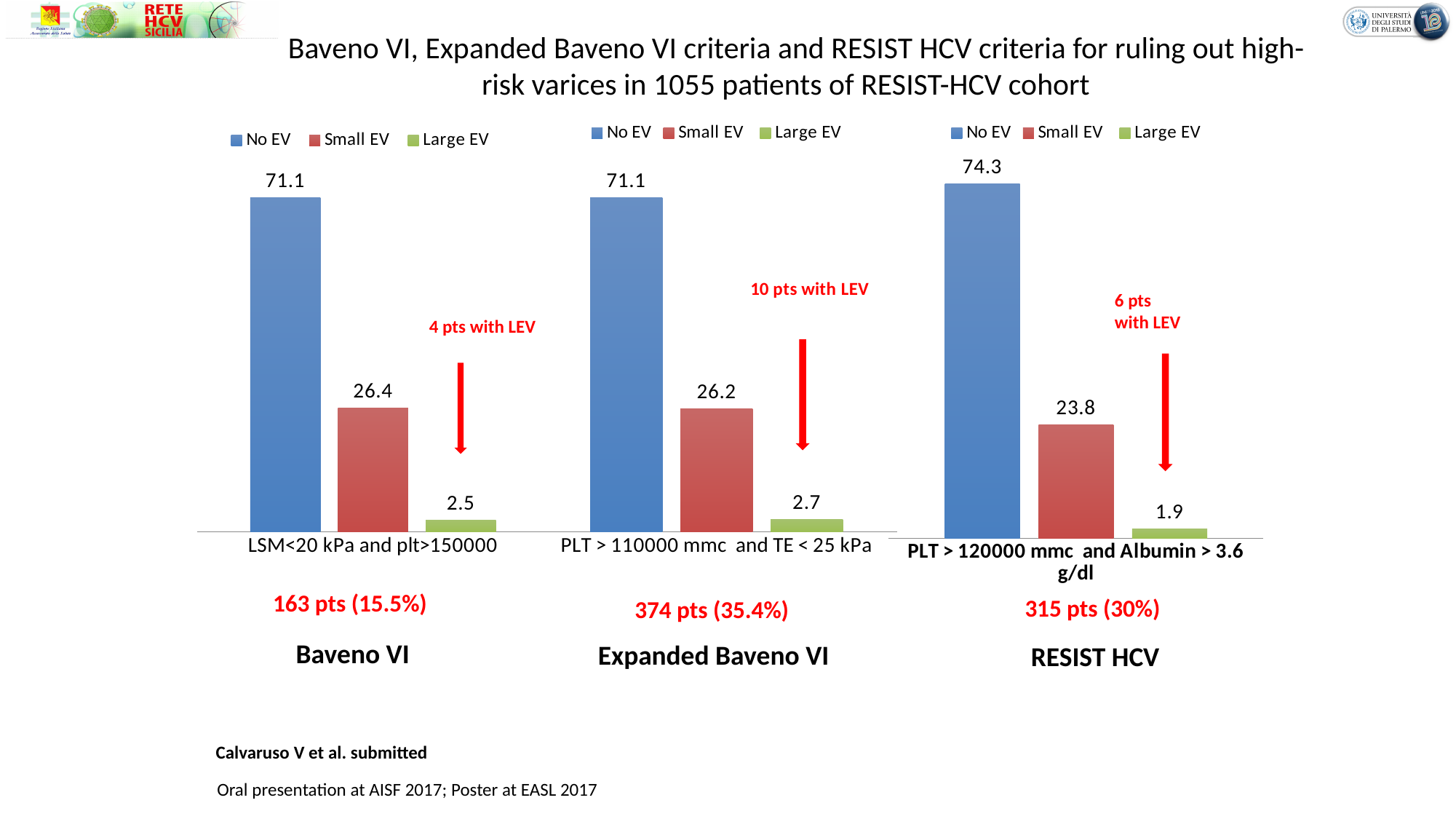
In the RESIST HCV chart (right), what is the value for No EV? 74.3 In the RESIST HCV chart (right), which series has the lowest value? Large EV Which is larger: the Small EV value in the Baveno VI chart (left) or the Small EV value in the RESIST HCV chart (right)? Baveno VI How many series does the legend of the Expanded Baveno VI chart (middle) list? 3 In the RESIST HCV chart (right), what is the difference between the Small EV and Large EV values? 21.9 In the Baveno VI chart (left), what is the difference between the No EV and Small EV values? 44.7 What type of chart is the Baveno VI chart (left)? Bar chart In the RESIST HCV chart (right), what is the value for Small EV? 23.8 In the Baveno VI chart (left), what is the value for Small EV? 26.4 In the Expanded Baveno VI chart (middle), which series has the highest value? No EV In the Baveno VI chart (left), what is the value for No EV? 71.1 In the Expanded Baveno VI chart (middle), what is the value for Large EV? 2.7